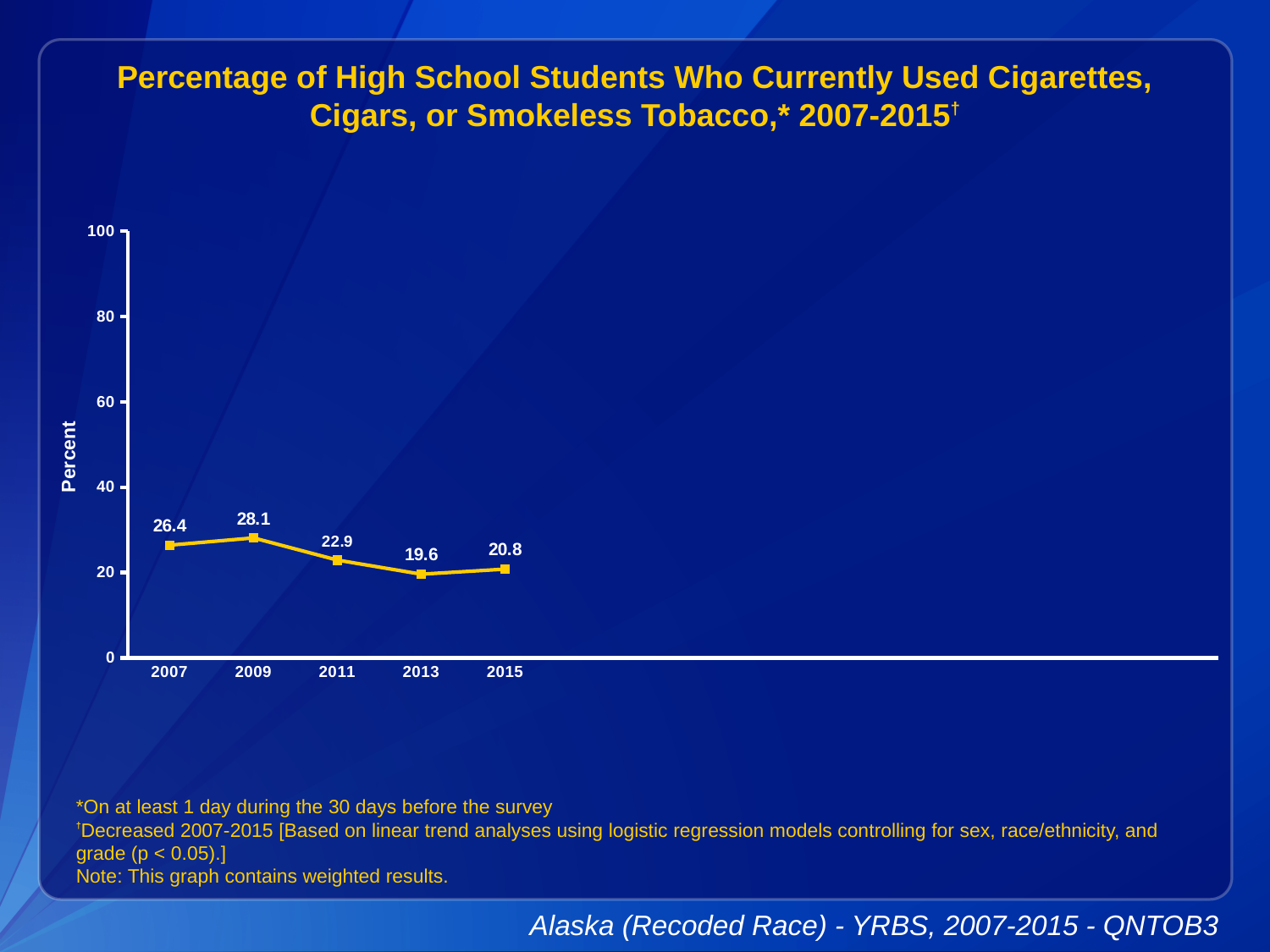
What is the label on the y axis? Percent What value is shown for 2015? 20.8 Which year has the lowest percentage? 2013 Which is larger, the value for 2007 or the value for 2015? 2007 What was the percentage of high school students who currently used cigarettes, cigars, or smokeless tobacco in 2007? 26.4 Is the value for 2009 greater or less than 40? less Which year has the highest percentage? 2009 How many years are plotted on the chart? 5 Overall, do the values rise or fall from 2007 to 2015? fall What is the difference between the 2009 value and the 2013 value? 8.5 What value is shown for 2011? 22.9 What kind of chart is shown? line chart